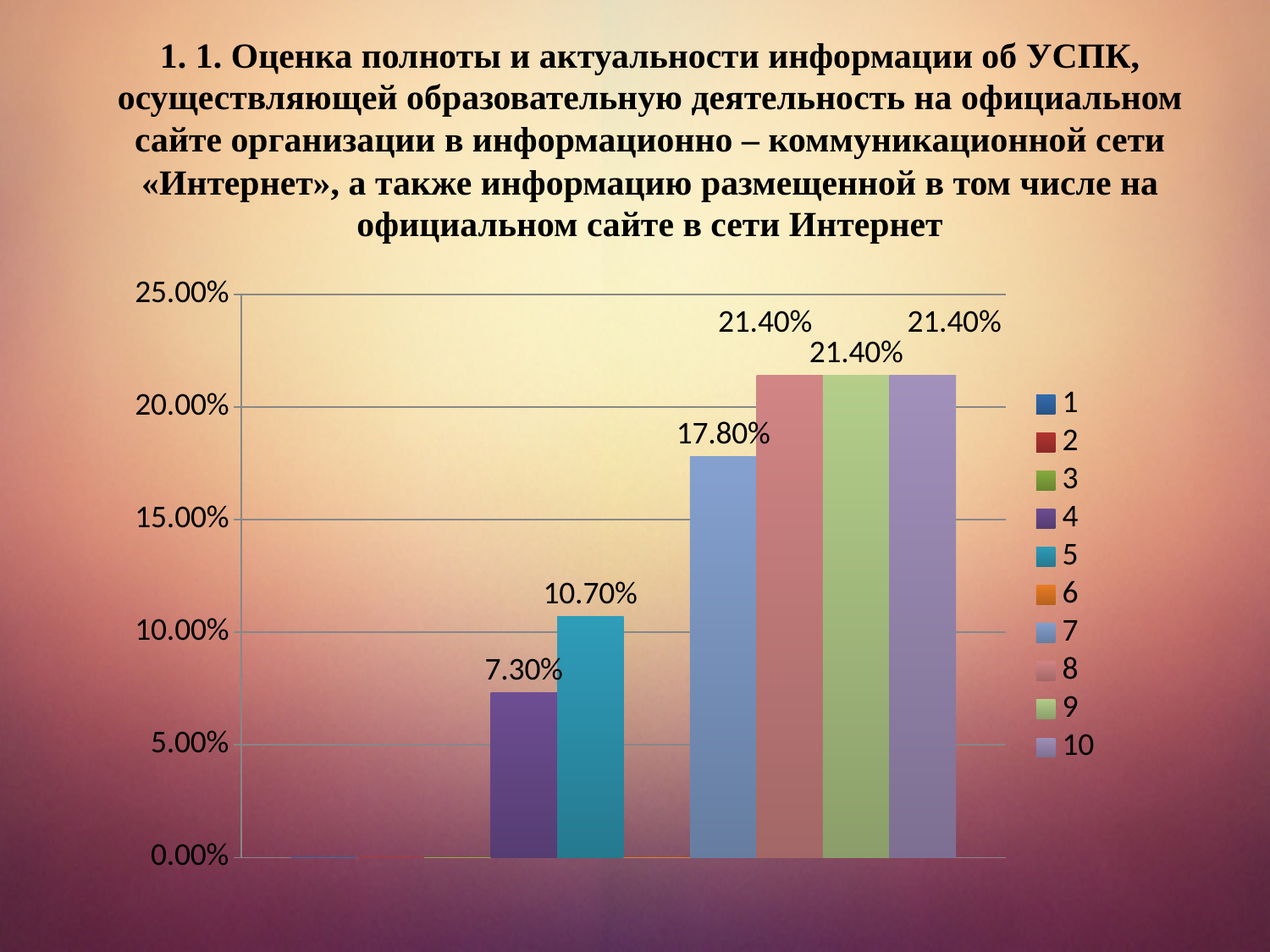
What is the highest value labelled on the chart? 21.40% Which is larger, the value for series 5 or the value for series 4? series 5 What is the value shown for series 4? 7.30% How many series does the legend list? 10 What is the difference between the values for series 7 and series 4? 10.50% What is the value shown for series 7? 17.80% Which series has the lowest visible bar on the chart? 4 Is the value for series 7 greater or less than 15.00%? greater What type of chart is shown on the slide? bar chart What is the value shown for series 8? 21.40% What is the value shown for series 5? 10.70% What is the difference between the values for series 8 and series 7? 3.60%